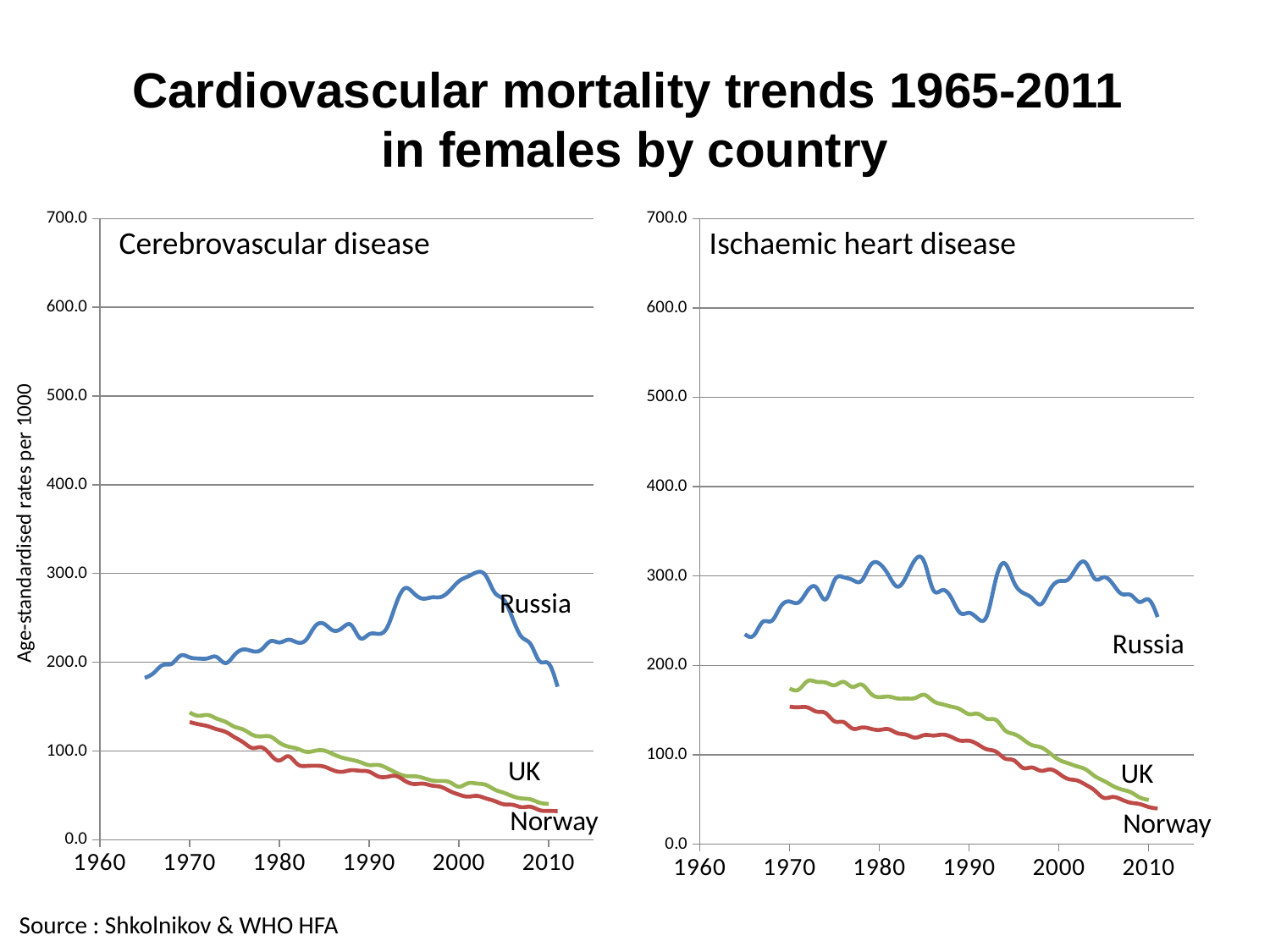
In the Cerebrovascular disease chart, which country has the highest mortality rate throughout the period? Russia In the Ischaemic heart disease chart, which is larger in 1970, the UK or Norway? UK In the Cerebrovascular disease chart, is the value for the UK in 1970 greater or less than 100? greater How many charts are shown on the slide? 2 In the Ischaemic heart disease chart, which country has the lowest mortality rate in 2010? Norway In the Cerebrovascular disease chart, does the UK line rise or fall from 1970 to 2010? fall In the Ischaemic heart disease chart, is the value for Russia in 1985 greater or less than 300? greater What kind of chart is the Cerebrovascular disease chart on the left? Line chart In the Cerebrovascular disease chart, is the value for Russia in 2010 greater or less than 300? less What is the label on the vertical axis of the left chart? Age-standardised rates per 1000 How many countries are plotted as lines in the Ischaemic heart disease chart? 3